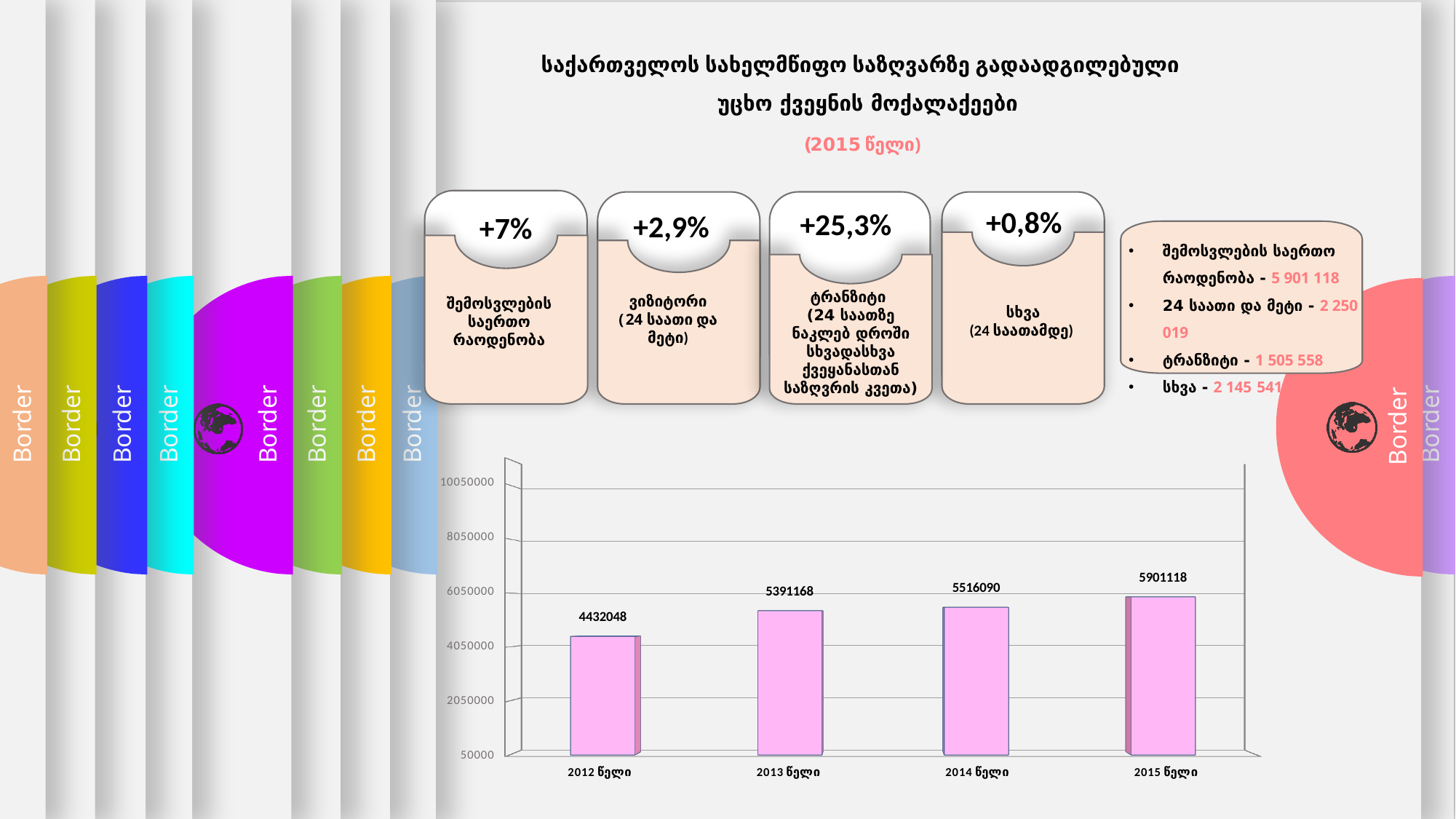
Which year has the highest value in the chart? 2015 წელი Is the value for 2015 წელი greater or less than 6050000? less How many bars (years) are plotted in the chart? 4 What is the value shown for 2013 წელი? 5391168 Which year has the lowest value in the chart? 2012 წელი What is the difference between the values for 2015 წელი and 2012 წელი? 1469070 What is the value shown for 2014 წელი? 5516090 Which is larger, the value for 2013 წელი or the value for 2012 წელი? 2013 წელი What type of chart is shown on the slide? bar chart What is the value shown for 2015 წელი? 5901118 Do the values rise or fall from 2012 to 2015 along the x axis? rise What is the value shown for 2012 წელი? 4432048